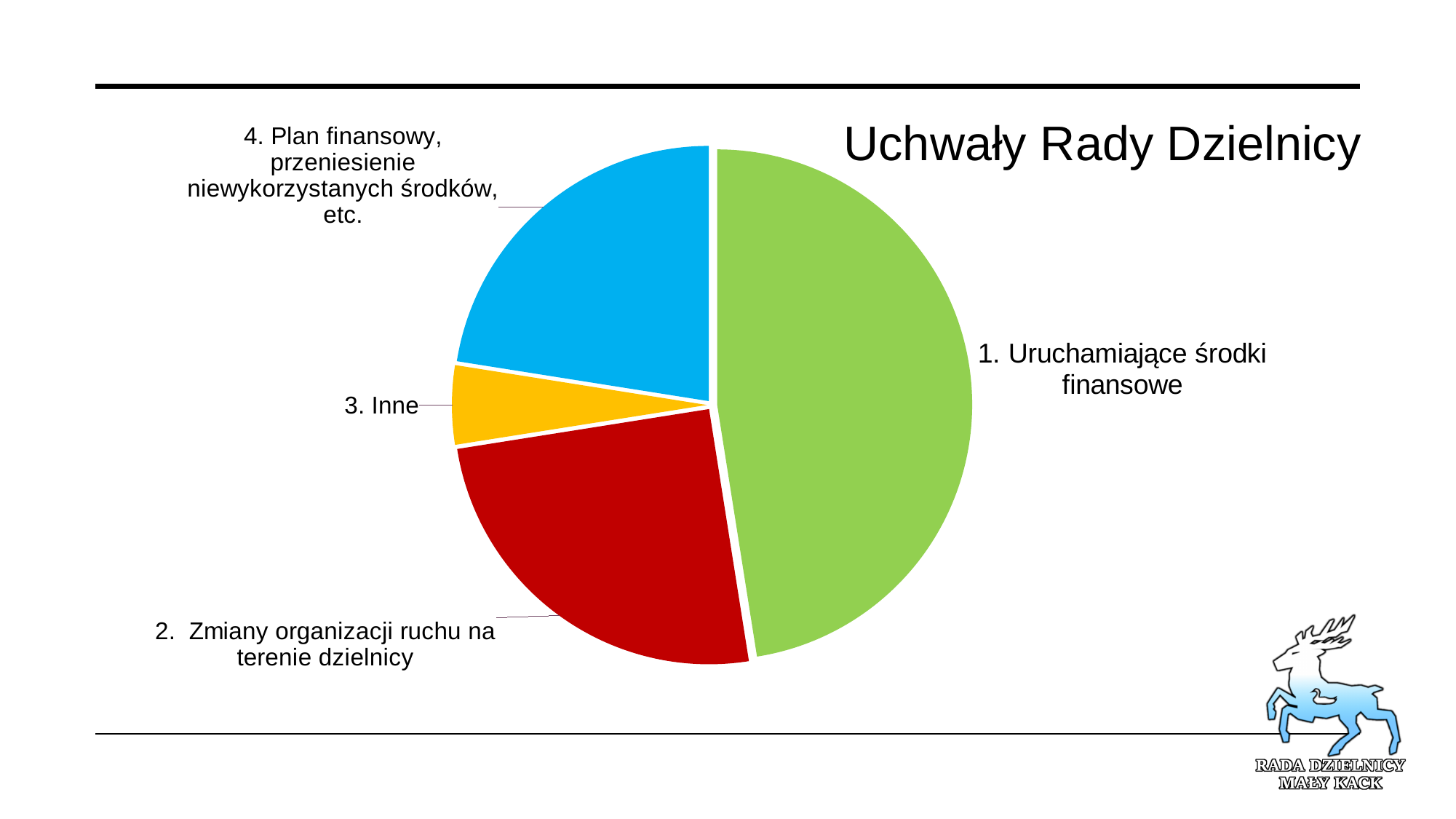
How many slices does the pie chart have? 4 What kind of chart is shown on the slide? pie chart Which category has the smallest slice of the pie? 3. Inne Which category has the largest slice of the pie? 1. Uruchamiające środki finansowe Which slice is larger: "2. Zmiany organizacji ruchu na terenie dzielnicy" or "4. Plan finansowy, przeniesienie niewykorzystanych środków, etc."? 2. Zmiany organizacji ruchu na terenie dzielnicy What colour is the slice for "3. Inne"? yellow What is the title of the chart? Uchwały Rady Dzielnicy Which slice is larger: "2. Zmiany organizacji ruchu na terenie dzielnicy" or "3. Inne"? 2. Zmiany organizacji ruchu na terenie dzielnicy Which slice is larger: "1. Uruchamiające środki finansowe" or "4. Plan finansowy, przeniesienie niewykorzystanych środków, etc."? 1. Uruchamiające środki finansowe